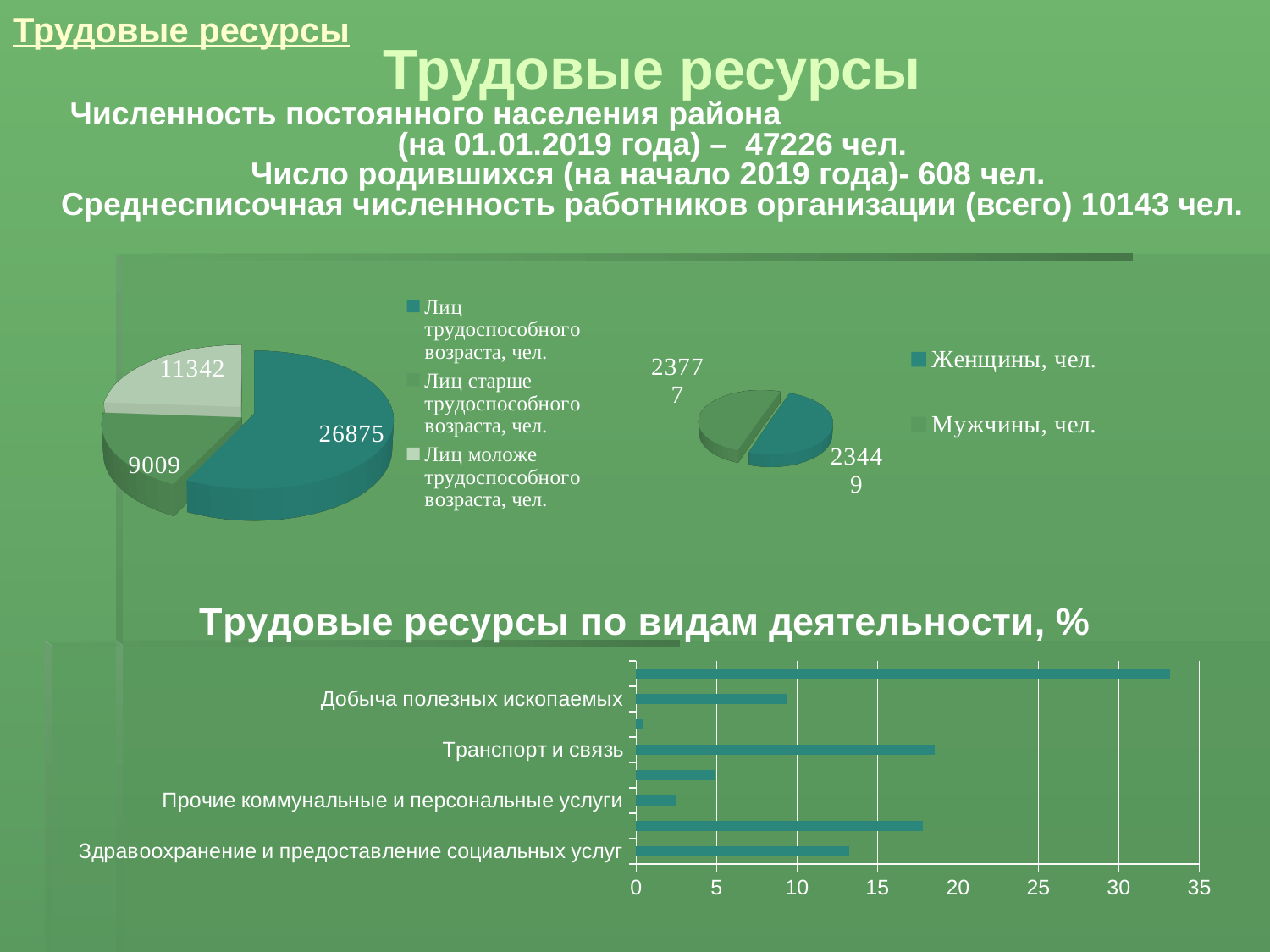
How many entries does the legend of the right pie chart list? 2 In the bottom bar chart, which is larger: 'Транспорт и связь' or 'Здравоохранение и предоставление социальных услуг'? Транспорт и связь In the left pie chart, what is the value for persons older than working age (Лиц старше трудоспособного возраста)? 9009 What type of chart is the bottom chart titled 'Трудовые ресурсы по видам деятельности, %'? bar chart In the left pie chart, what is the value for persons of working age (Лиц трудоспособного возраста)? 26875 In the bottom bar chart, is the value for 'Транспорт и связь' greater or less than 15? greater In the left pie chart, which category has the smallest slice? Лиц старше трудоспособного возраста, чел. In the bottom bar chart, is the value for 'Прочие коммунальные и персональные услуги' greater or less than 5? less In the left pie chart, what is the value for persons younger than working age (Лиц моложе трудоспособного возраста)? 11342 How many bars are plotted in the bottom chart 'Трудовые ресурсы по видам деятельности, %'? 8 In the left pie chart, which category has the largest slice? Лиц трудоспособного возраста, чел. In the left pie chart, what is the difference between the working-age value and the younger-than-working-age value? 15533